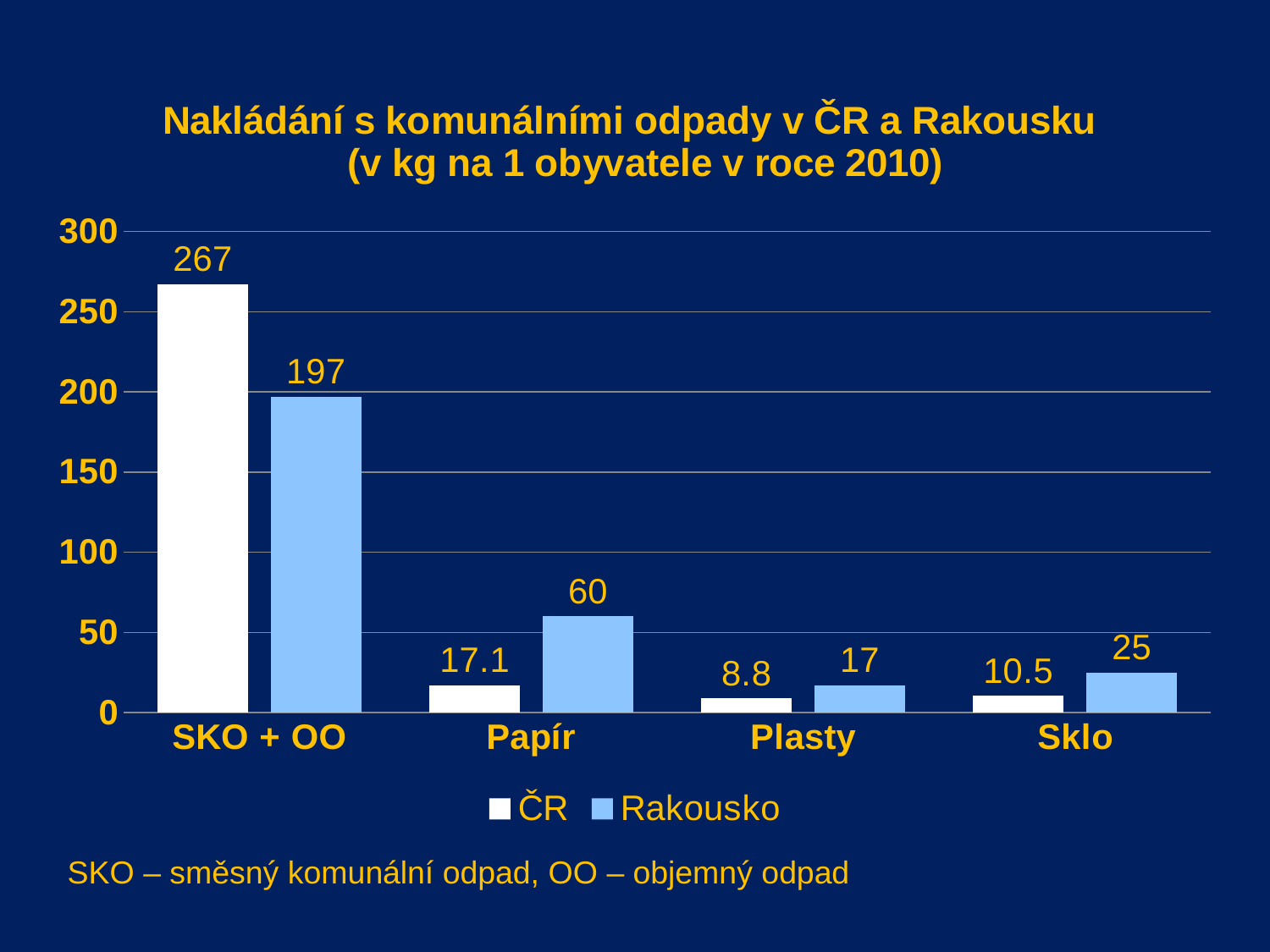
What is the difference between the ČR and Rakousko values in the SKO + OO category? 70 How many series does the legend list? 2 How many categories are shown on the x axis? 4 What is the difference between the Rakousko and ČR values in the Sklo category? 14.5 Which category has the lowest value for ČR? Plasty What kind of chart is shown on the slide? Bar chart What is the value for ČR in the Sklo category? 10.5 What is the value for Rakousko in the Papír category? 60 What is the value for ČR in the SKO + OO category? 267 What is the value for Rakousko in the Plasty category? 17 Which is larger in the Papír category, the value for ČR or for Rakousko? Rakousko Which category has the highest value for Rakousko? SKO + OO